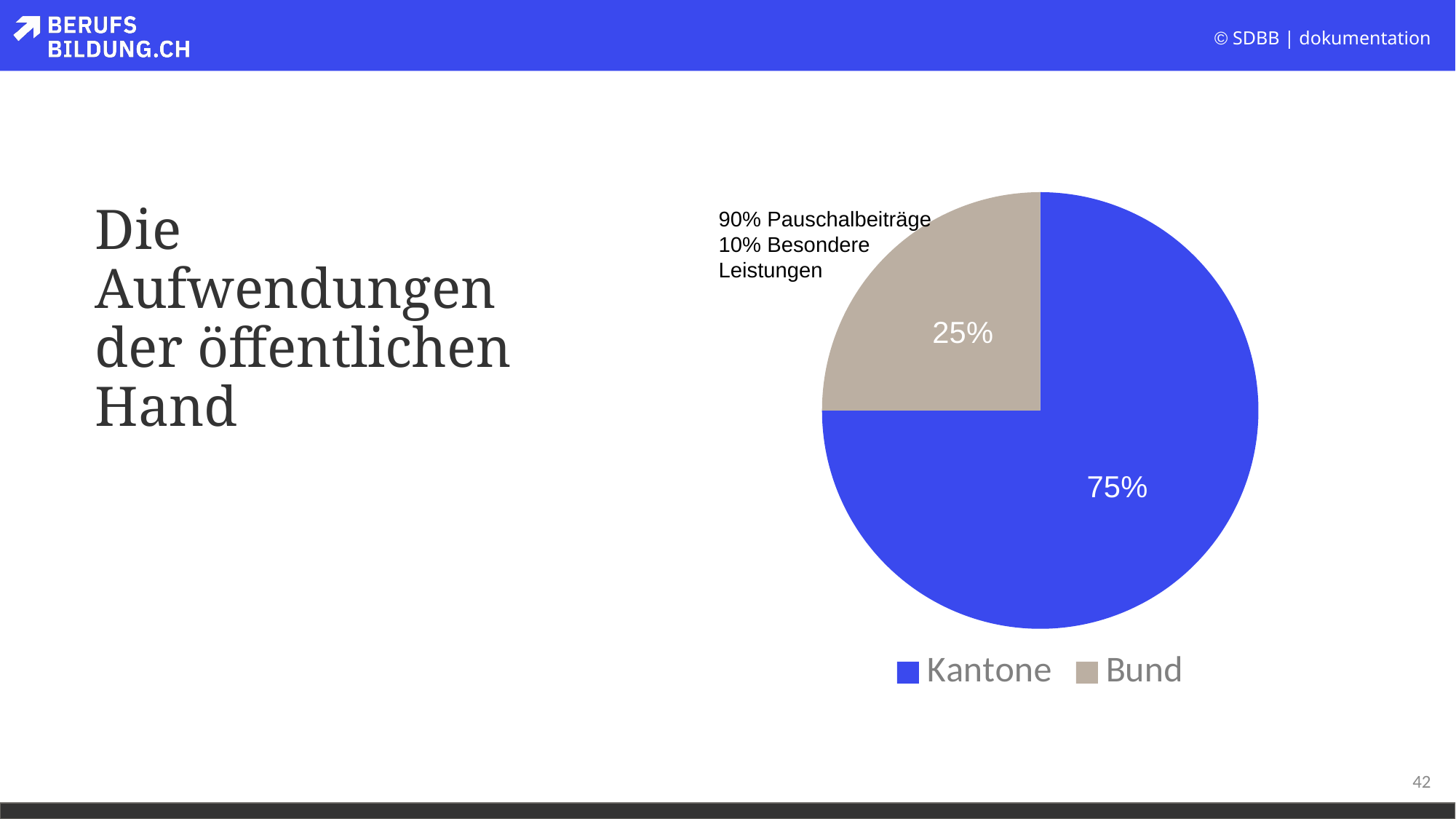
What colour is the Kantone slice in the pie chart? Blue How many slices does the pie chart have? 2 Which category has the largest slice of the pie? Kantone What is the difference in percentage points between the Kantone slice and the Bund slice? 50 What share of the pie does Bund account for? 25% How many entries does the legend list? 2 What kind of chart is shown on the slide? Pie chart According to the annotation next to the Bund slice, what percentage is Pauschalbeiträge? 90% Which category has the smallest slice of the pie? Bund What share of the pie does Kantone account for? 75% Which is larger, the Kantone slice or the Bund slice? Kantone According to the annotation next to the Bund slice, what percentage is Besondere Leistungen? 10%